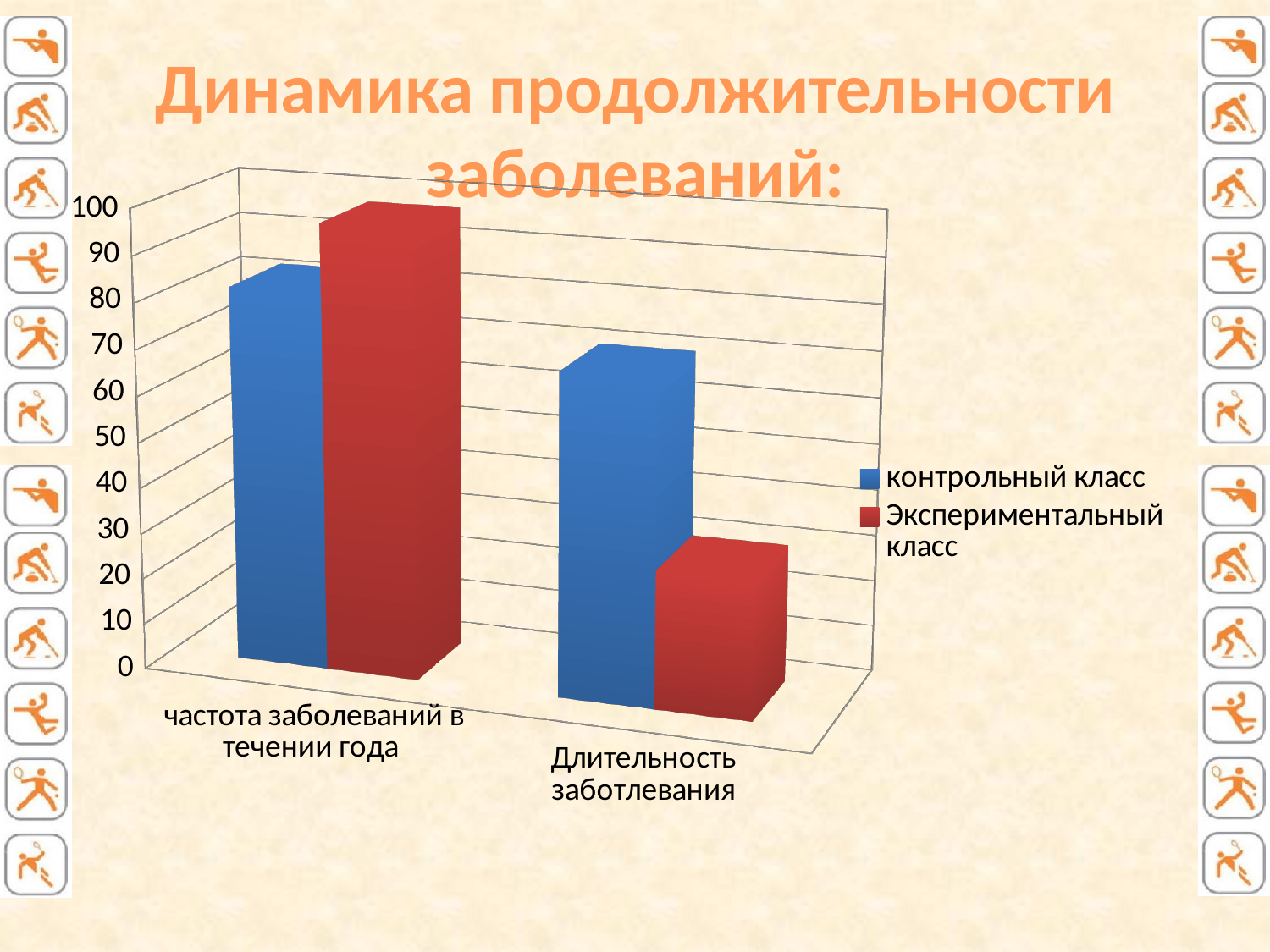
Which bar is the tallest in the chart? Экспериментальный класс, частота заболеваний в течении года What kind of chart is shown on the slide? bar chart For "Длительность заботлевания", which series has the larger value, контрольный класс or Экспериментальный класс? контрольный класс Is the value for Экспериментальный класс in "Длительность заботлевания" greater or less than 50? less What is the title of the slide above the chart? Динамика продолжительности заболеваний: Is the value for контрольный класс in "частота заболеваний в течении года" greater or less than 50? greater How many series does the legend list? 2 Which bar is the shortest in the chart? Экспериментальный класс, Длительность заботлевания Is the value for контрольный класс in "Длительность заботлевания" greater or less than 50? greater How many categories are shown on the x axis? 2 Which series is shown in red? Экспериментальный класс For "частота заболеваний в течении года", which series has the larger value, контрольный класс or Экспериментальный класс? Экспериментальный класс